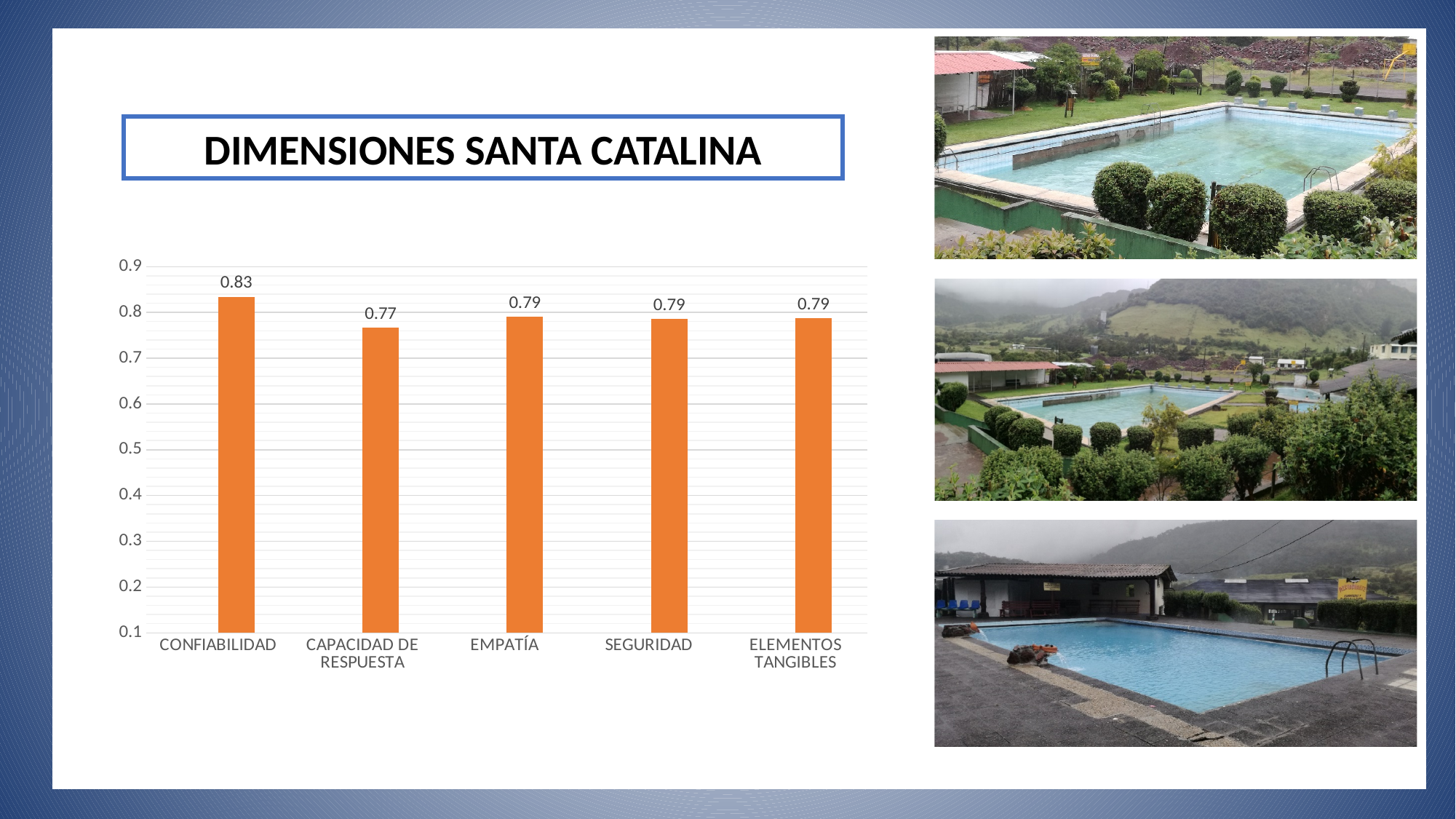
Which is larger, the value for CONFIABILIDAD or the value for SEGURIDAD? CONFIABILIDAD What is the title shown above the chart? DIMENSIONES SANTA CATALINA What is the value for EMPATÍA? 0.79 What is the value for CAPACIDAD DE RESPUESTA? 0.77 Which category has the highest value? CONFIABILIDAD What is the value for CONFIABILIDAD? 0.83 Which category has the lowest value? CAPACIDAD DE RESPUESTA What kind of chart is shown on the slide? Bar chart What is the value for ELEMENTOS TANGIBLES? 0.79 What is the difference between the values for CONFIABILIDAD and CAPACIDAD DE RESPUESTA? 0.06 What is the value for SEGURIDAD? 0.79 How many categories are shown in the chart? 5